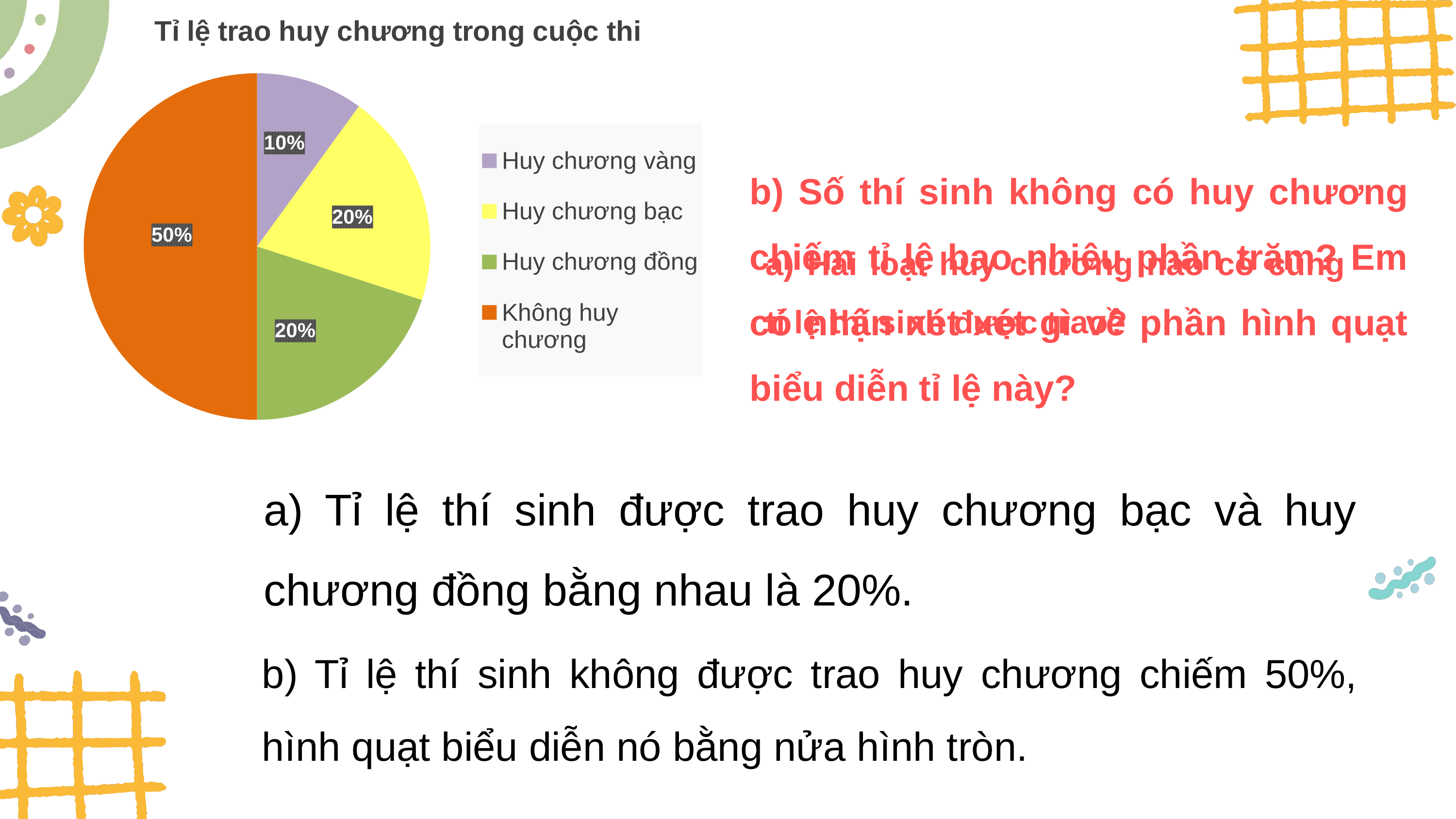
What is the difference between the share for Không huy chương and the share for Huy chương vàng? 40% Which category has the largest share of the pie? Không huy chương How many categories does the legend list? 4 Which category has the smallest share of the pie? Huy chương vàng Which is larger, the share for Huy chương bạc or the share for Huy chương vàng? Huy chương bạc What colour is the slice for Không huy chương? Orange What percentage of the pie is Không huy chương? 50% What is the combined share of Huy chương bạc and Huy chương đồng? 40% What percentage of the pie is Huy chương vàng? 10% What percentage of the pie is Huy chương bạc? 20% What kind of chart is shown on the slide? Pie chart What is the title of the chart? Tỉ lệ trao huy chương trong cuộc thi